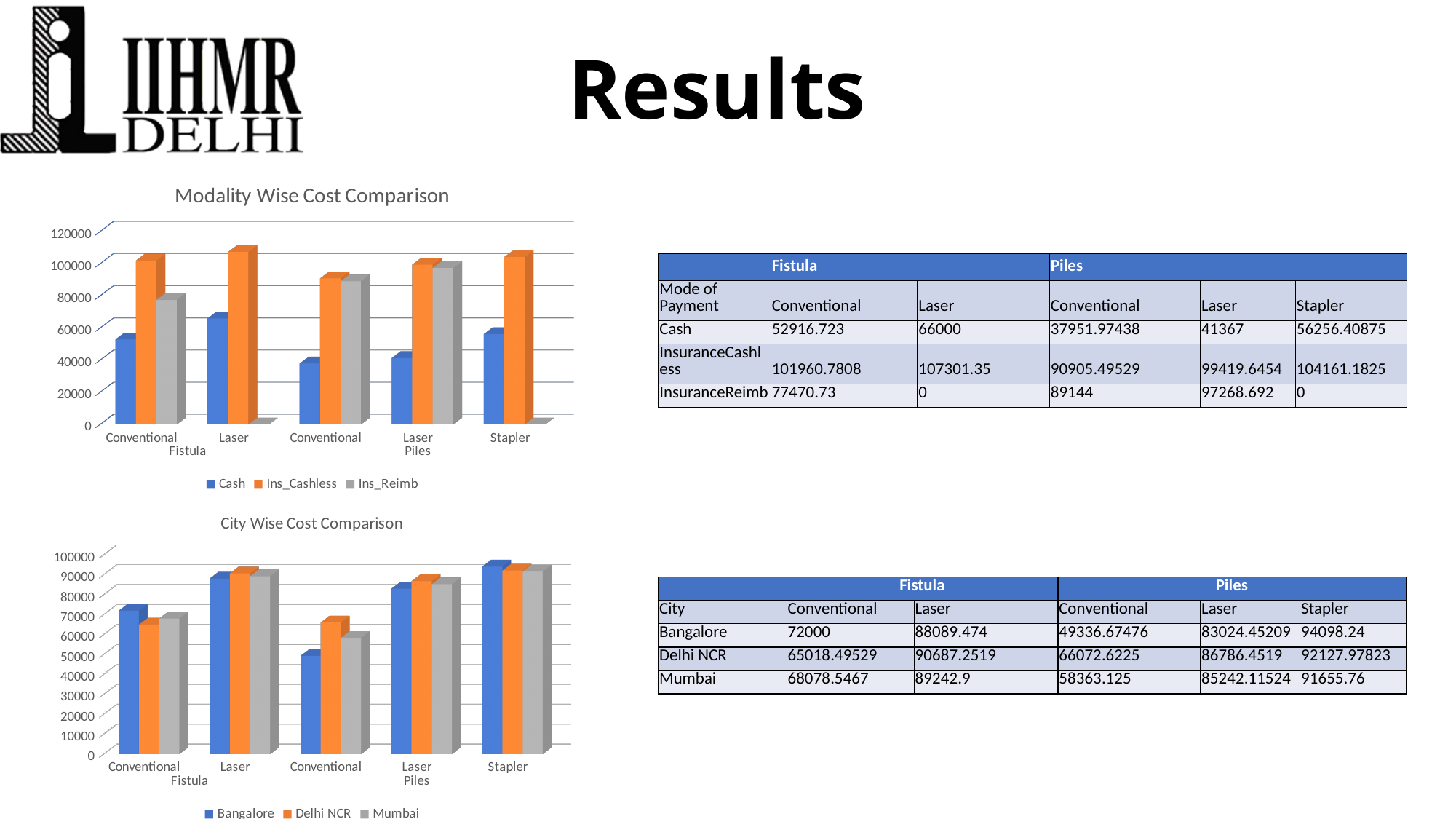
In the 'Modality Wise Cost Comparison' chart, is the Ins_Reimb value for Laser under Fistula greater or less than 20000? less In the 'Modality Wise Cost Comparison' chart, is the Ins_Cashless value for Conventional under Fistula greater or less than 80000? greater How many series does the legend of the 'City Wise Cost Comparison' chart list? 3 In the 'City Wise Cost Comparison' chart, which city has the lowest value for Conventional under Piles? Bangalore In the 'City Wise Cost Comparison' chart, is the Bangalore value for Stapler greater or less than 90000? greater How many series does the legend of the 'Modality Wise Cost Comparison' chart list? 3 What kind of chart is the 'Modality Wise Cost Comparison' chart? bar chart In the 'Modality Wise Cost Comparison' chart, which series has the highest value for Laser under Fistula? Ins_Cashless In the 'Modality Wise Cost Comparison' chart, which series has the lowest value for Conventional under Fistula? Cash In the 'City Wise Cost Comparison' chart, which is larger for Conventional under Fistula: Bangalore or Delhi NCR? Bangalore What are the legend entries of the 'City Wise Cost Comparison' chart? Bangalore, Delhi NCR, Mumbai How many categories are shown on the x axis of the 'Modality Wise Cost Comparison' chart? 5